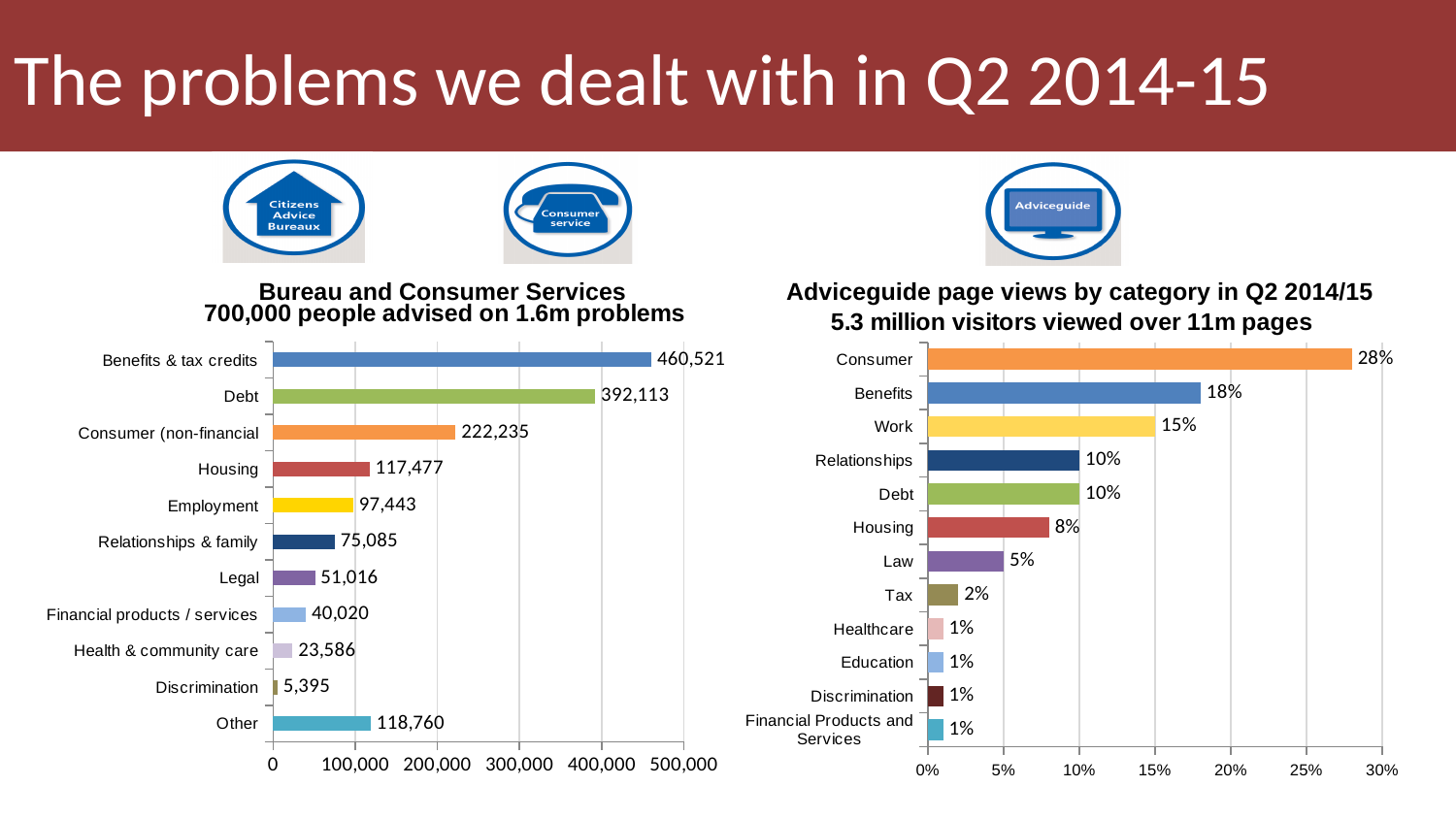
In the Bureau and Consumer Services chart, which is larger: Employment or Other? Other How many categories are shown in the Bureau and Consumer Services chart? 11 What type of chart is the Adviceguide page views chart? Bar chart How many categories are shown in the Adviceguide page views chart? 12 In the Adviceguide page views chart, which category has the highest value? Consumer In the Adviceguide page views chart, what is the value for Work? 15% In the Bureau and Consumer Services chart, which category has the highest value? Benefits & tax credits In the Bureau and Consumer Services chart, what is the value for Housing? 117,477 In the Bureau and Consumer Services chart, which category has the lowest value? Discrimination In the Adviceguide page views chart, what is the difference between Consumer and Benefits? 10% In the Bureau and Consumer Services chart, what is the difference between Benefits & tax credits and Debt? 68,408 In the Bureau and Consumer Services chart, what is the value for Debt? 392,113